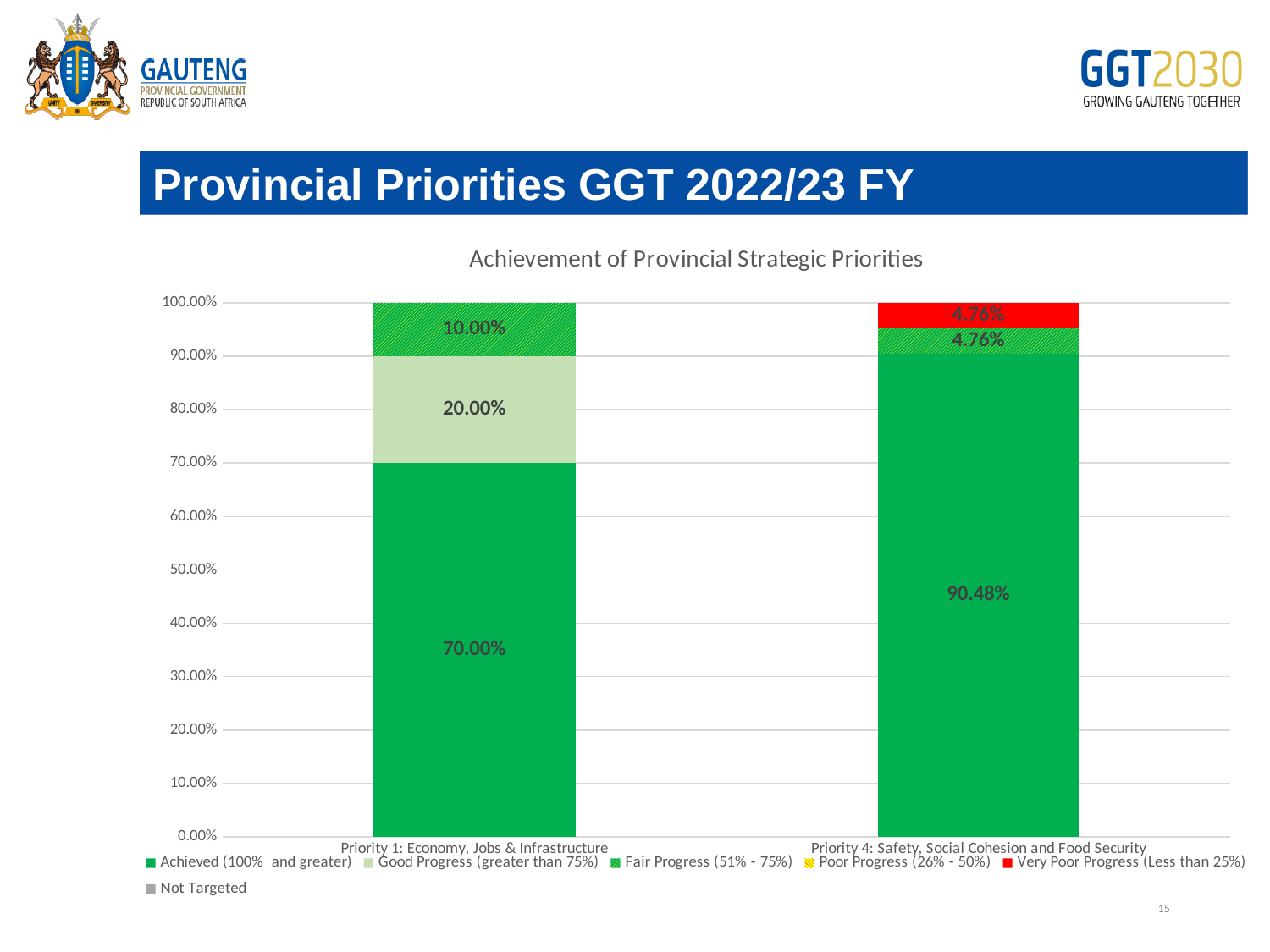
What is the Good Progress (greater than 75%) value for Priority 1: Economy, Jobs & Infrastructure? 20.00% What is the Achieved (100% and greater) value for Priority 4: Safety, Social Cohesion and Food Security? 90.48% What is the Fair Progress (51% - 75%) value for Priority 1: Economy, Jobs & Infrastructure? 10.00% What is the Very Poor Progress (Less than 25%) value for Priority 4: Safety, Social Cohesion and Food Security? 4.76% What is the difference between the Achieved values for Priority 4: Safety, Social Cohesion and Food Security and Priority 1: Economy, Jobs & Infrastructure? 20.48% What is the Achieved (100% and greater) value for Priority 1: Economy, Jobs & Infrastructure? 70.00% Is the Achieved (100% and greater) value for Priority 1: Economy, Jobs & Infrastructure greater or less than 60.00%? greater What is the title of the chart? Achievement of Provincial Strategic Priorities How many series does the legend list? 6 Which category has the higher Achieved (100% and greater) value? Priority 4: Safety, Social Cohesion and Food Security What kind of chart is shown on the slide? Stacked bar chart How many categories are plotted on the x axis? 2